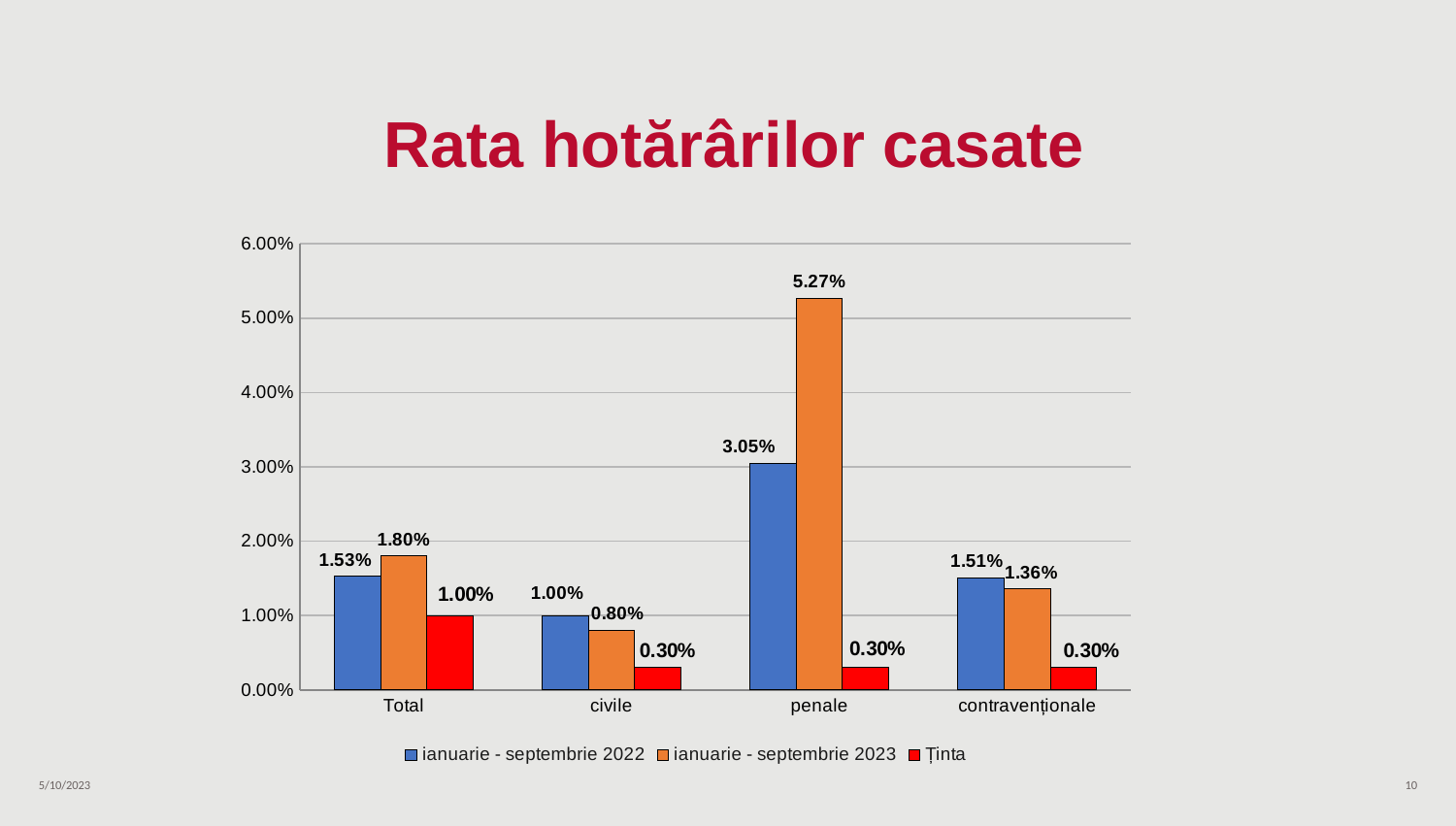
What is the value for 'penale' in the 'ianuarie - septembrie 2023' series? 5.27% What is the value for 'Total' in the 'ianuarie - septembrie 2022' series? 1.53% What is the 'Ținta' value for 'civile'? 0.30% How many categories are shown on the x axis? 4 Which is larger for 'contravenționale': the 'ianuarie - septembrie 2022' value or the 'ianuarie - septembrie 2023' value? ianuarie - septembrie 2022 How many series does the legend list? 3 What kind of chart is shown on the slide? bar chart What is the title of the slide? Rata hotărârilor casate Is the 'ianuarie - septembrie 2022' value for 'penale' greater or less than 3.00%? greater What is the difference between the 'ianuarie - septembrie 2023' and 'ianuarie - septembrie 2022' values for 'penale'? 2.22% Which category has the lowest value in the 'ianuarie - septembrie 2022' series? civile Which category has the highest value in the 'ianuarie - septembrie 2023' series? penale